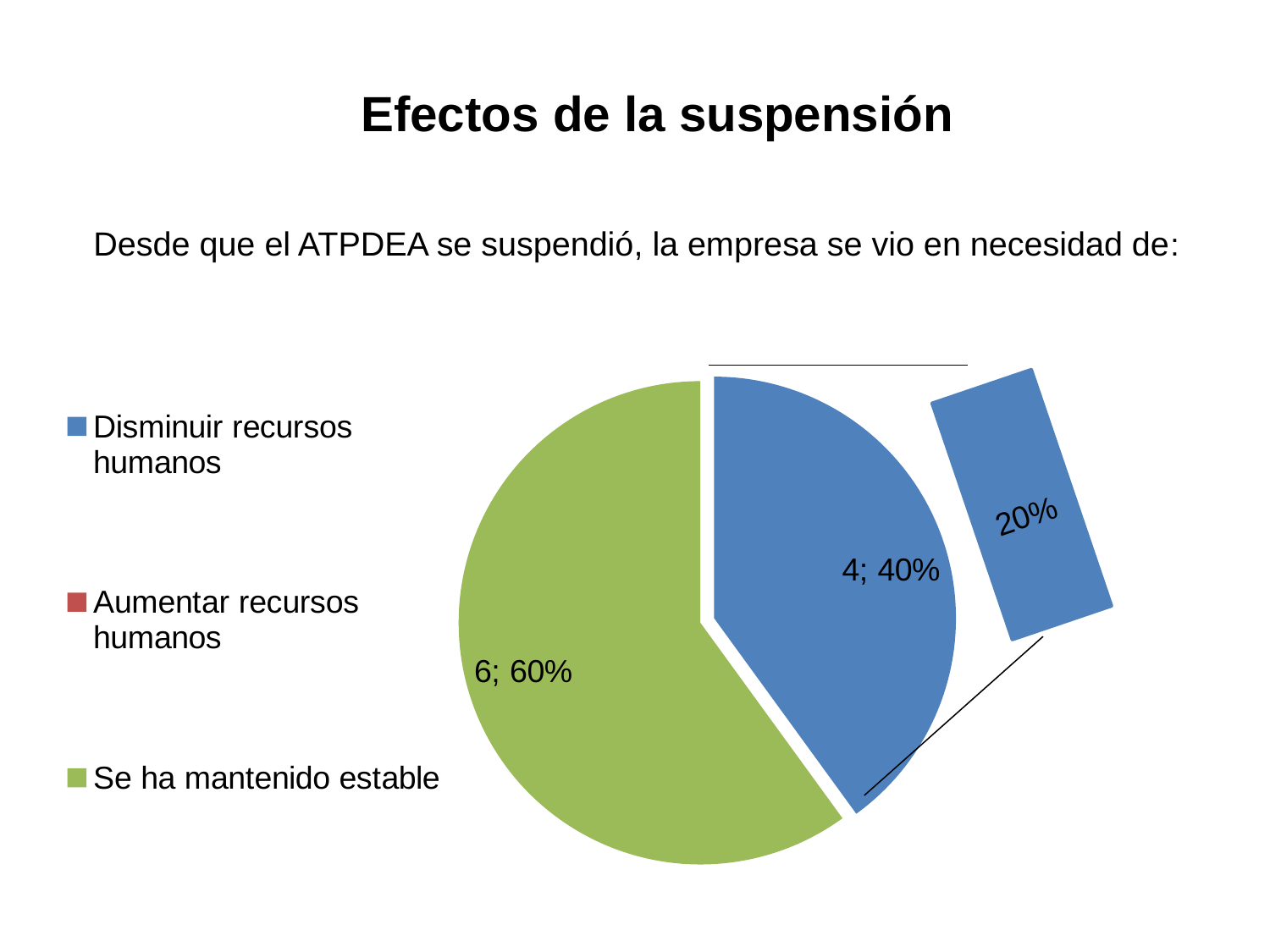
Which category has the largest slice of the pie? Se ha mantenido estable What is the difference between the values for 'Se ha mantenido estable' and 'Disminuir recursos humanos'? 2 What share of the pie does 'Disminuir recursos humanos' represent? 40% What value is labelled on the slice for 'Disminuir recursos humanos'? 4 What value is labelled on the slice for 'Se ha mantenido estable'? 6 What is the total of the values labelled on the pie slices? 10 Which of the two visible slices is larger: 'Disminuir recursos humanos' or 'Se ha mantenido estable'? Se ha mantenido estable What share of the pie does 'Se ha mantenido estable' represent? 60% What kind of chart is shown on the slide? pie chart What colour is the slice for 'Se ha mantenido estable'? green What is the title of the slide containing the chart? Efectos de la suspensión How many entries does the chart's legend list? 3